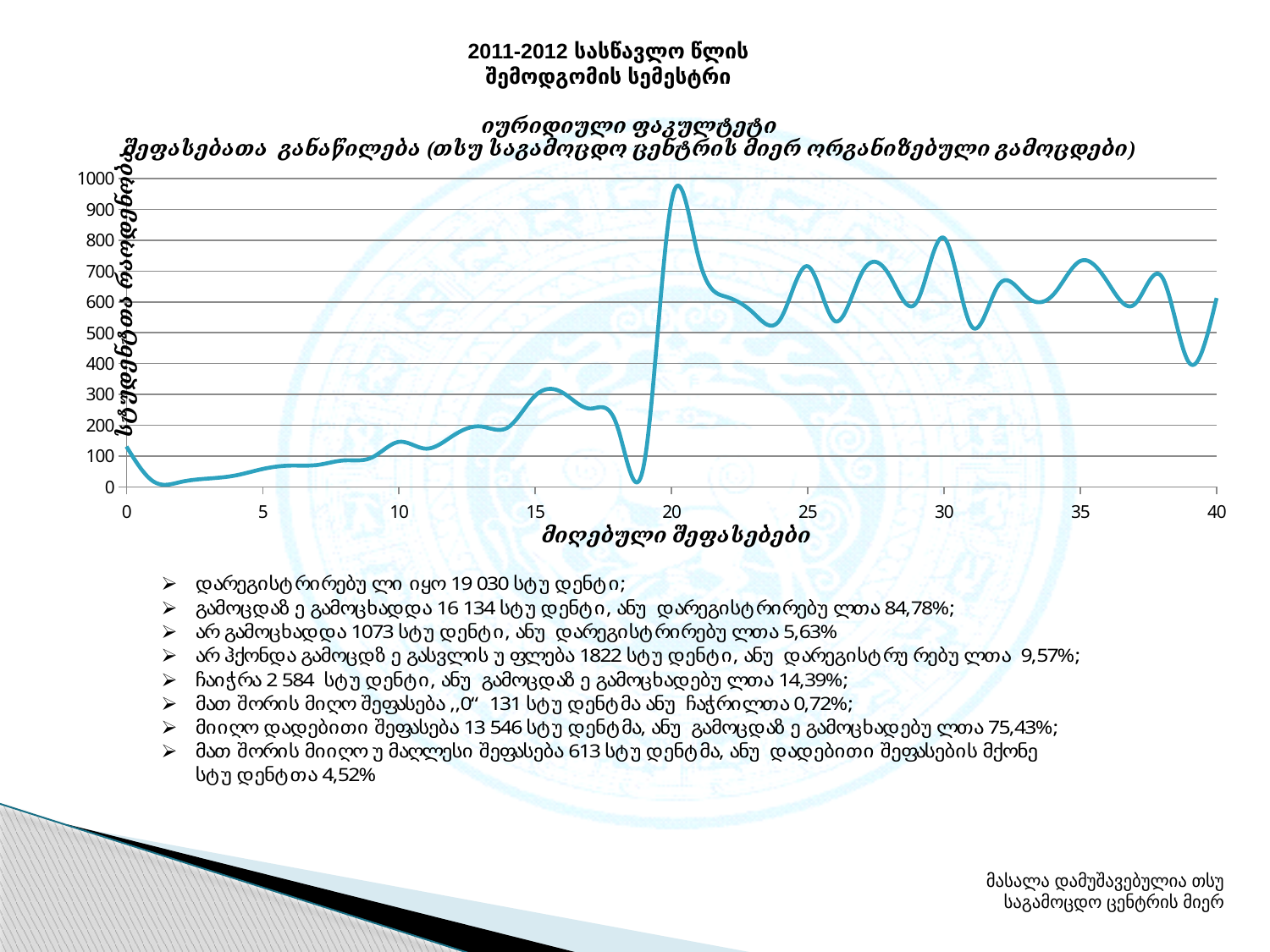
Does the line rise or fall between score 20 and score 22? fall Is the value of the line at score 30 greater or less than 700? greater What is the title of the chart? შეფასებათა განაწილება (თსუ საგამოცდო ცენტრის მიერ ორგანიზებული გამოცდები) Is the value of the line at score 39 greater or less than 500? less Is the value of the line at score 5 greater or less than 100? less What kind of chart is shown on the slide? line chart What is the label of the x axis of the chart? მიღებული შეფასებები Which has the larger value on the line, score 20 or score 10? score 20 Does the line rise or fall between score 10 and score 15? rise At which score on the x axis does the line reach its highest value? 20